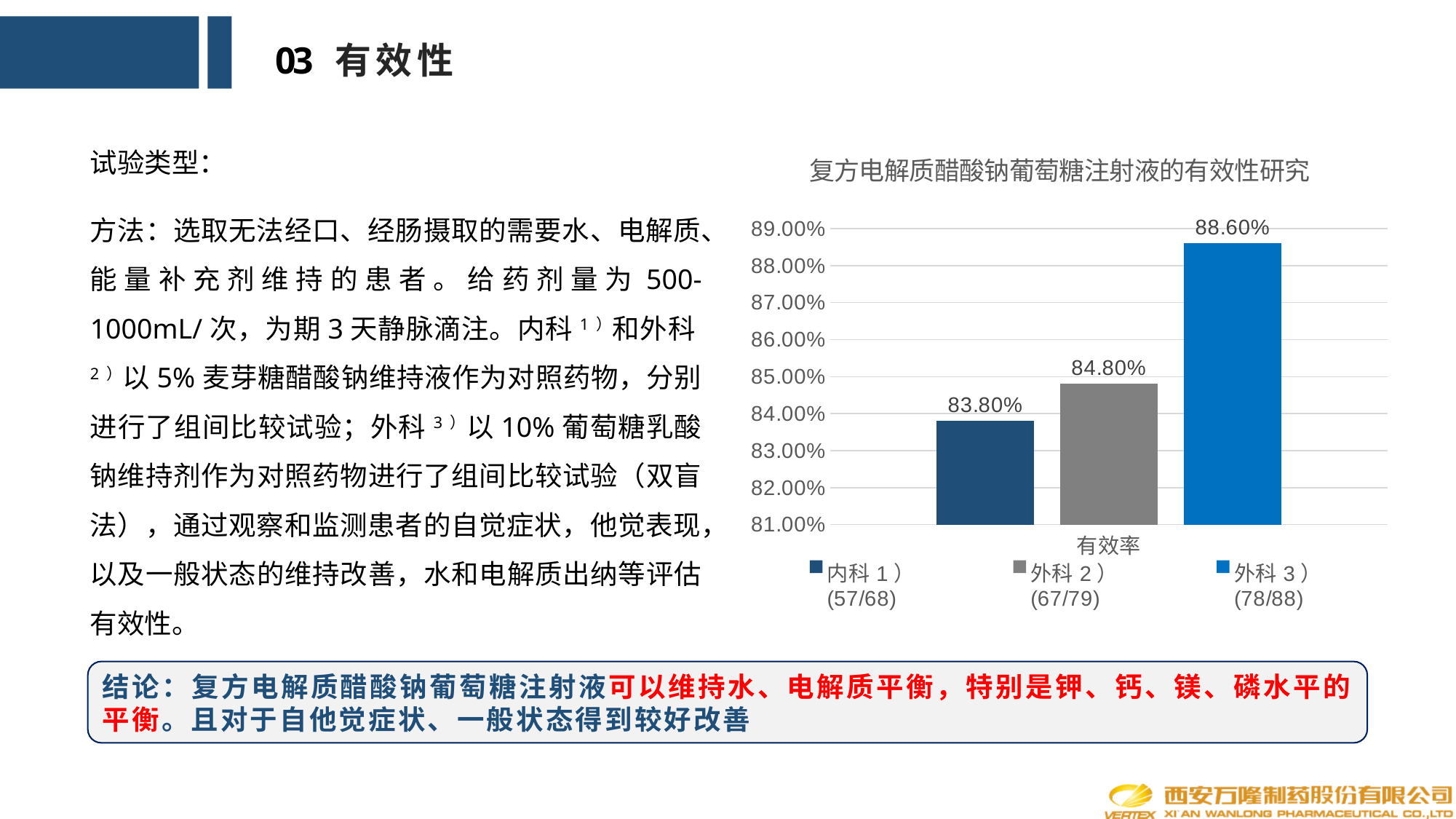
Which has a higher 有效率, 外科 2） or 外科 3）? 外科 3） What is the 有效率 value for 外科 2）? 84.80% Is the 有效率 for 内科 1） greater or less than 85.00%? less What is the 有效率 value for 内科 1）? 83.80% What is the title of the chart? 复方电解质醋酸钠葡萄糖注射液的有效性研究 What is the difference in 有效率 between 外科 3） and 内科 1）? 4.80% Which group has the lowest 有效率? 内科 1） What kind of chart is shown on the slide? bar chart What is the 有效率 value for 外科 3）? 88.60% What is the difference in 有效率 between 外科 2） and 内科 1）? 1.00% How many series does the legend list? 3 Which group has the highest 有效率? 外科 3）